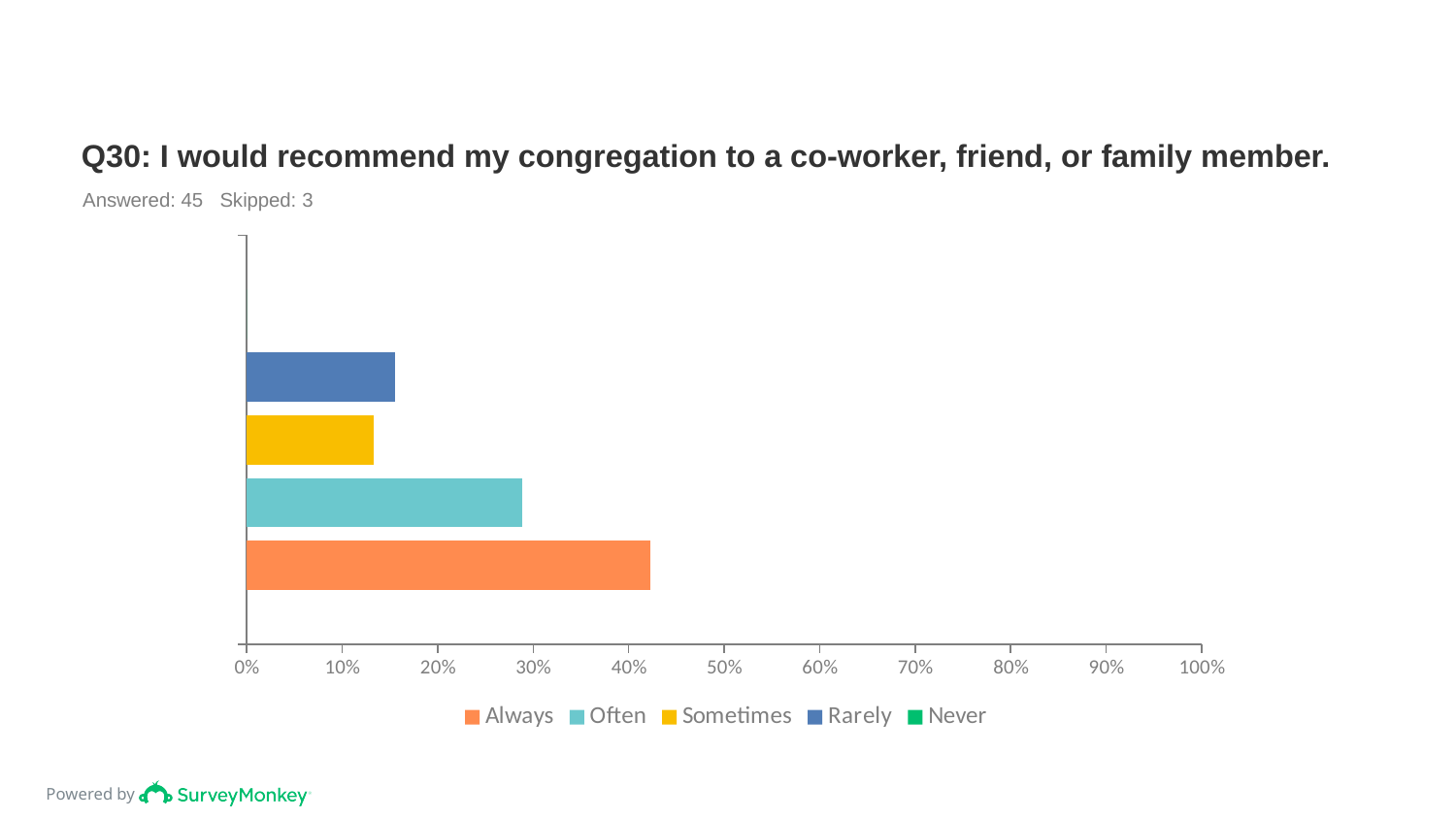
What kind of chart is shown on the slide? bar chart What colour is the bar for Always? orange Is the value for Often greater or less than 20%? greater Is the value for Always greater or less than 40%? greater Which category has the highest value? Always How many respondents answered this question according to the slide? 45 How many entries does the legend list? 5 Is the value for Rarely greater or less than 20%? less Which is larger, the value for Often or the value for Sometimes? Often Which is larger, the value for Always or the value for Often? Always